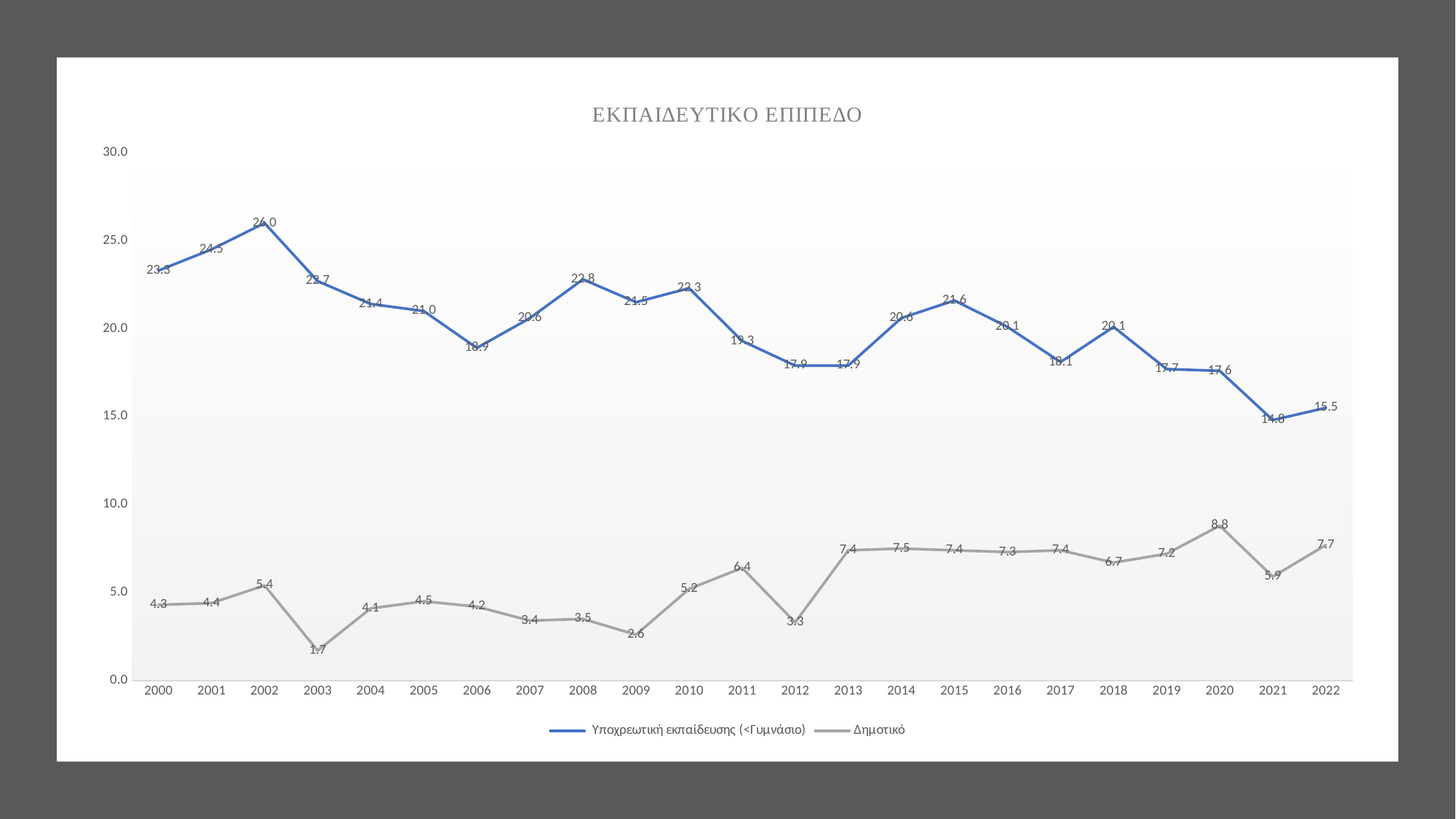
What type of chart is shown on the slide? Line chart How many series does the legend list? 2 In which year does the Δημοτικό series reach its lowest value? 2003 What is the difference between the Υποχρεωτική εκπαίδευσης (<Γυμνάσιο) value in 2000 and in 2022? 7.8 What is the value of the Υποχρεωτική εκπαίδευσης (<Γυμνάσιο) series in 2002? 26.0 How many years are plotted along the x axis? 23 Does the Υποχρεωτική εκπαίδευσης (<Γυμνάσιο) series generally rise or fall from 2000 to 2022? Fall Which is larger: the Δημοτικό value in 2011 or in 2012? 2011 What is the title of the chart? ΕΚΠΑΙΔΕΥΤΙΚΟ ΕΠΙΠΕΔΟ What is the value of the Δημοτικό series in 2020? 8.8 In which year does the Δημοτικό series reach its highest value? 2020 In which year does the Υποχρεωτική εκπαίδευσης (<Γυμνάσιο) series reach its lowest value? 2021